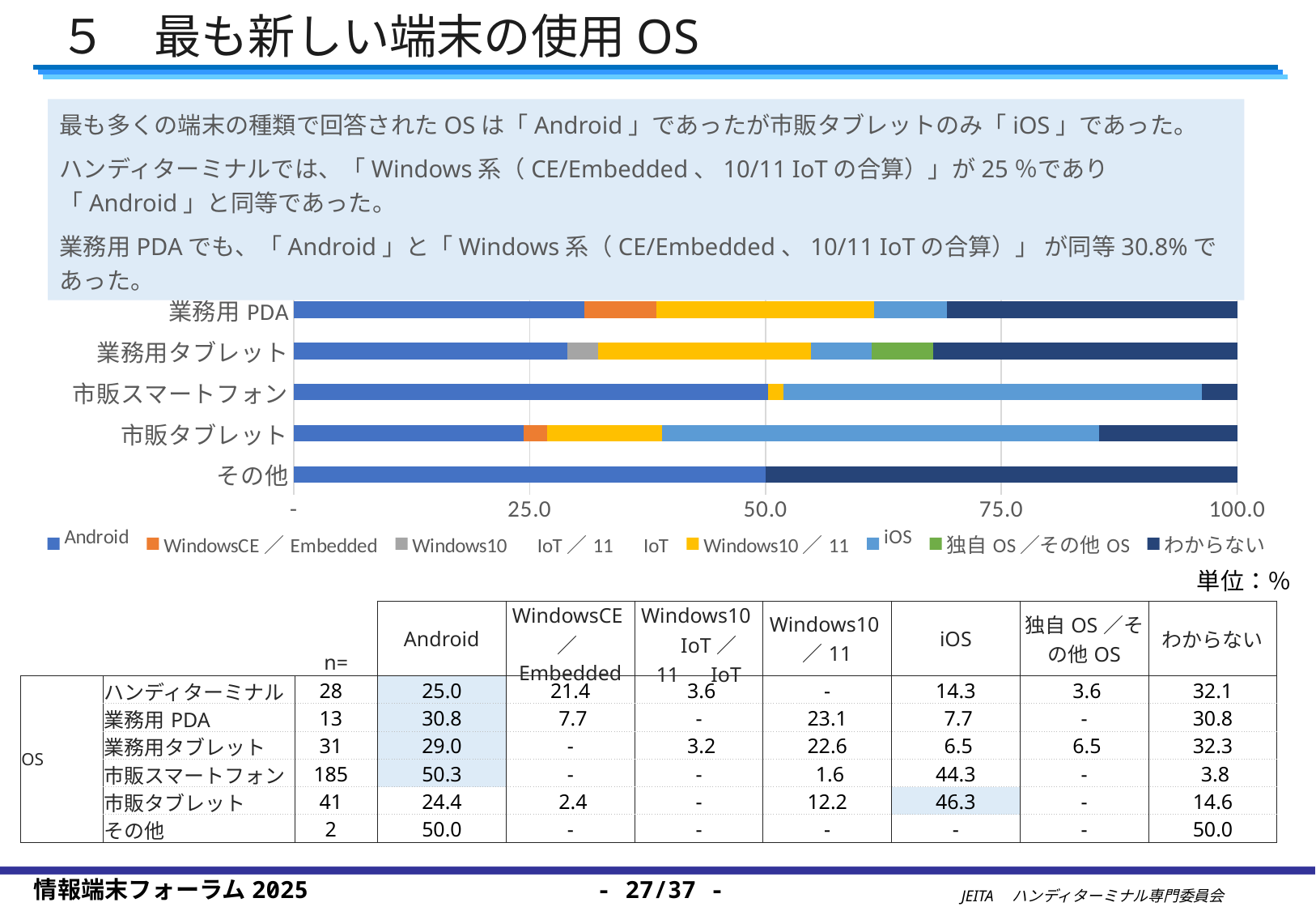
Which device category has the smallest わからない share? 市販スマートフォン What colour represents iOS in the chart legend? light blue What kind of chart is shown on the slide? stacked bar chart What is the difference between the iOS share for 市販タブレット and the iOS share for 市販スマートフォン? 2.0 What is the iOS share for 市販タブレット? 46.3 How many device categories are visible on the chart's vertical axis? 5 What is the Android share for 市販スマートフォン? 50.3 Which is larger for 業務用PDA: the Android share or the Windows10／11 share? Android How many series does the chart legend list? 7 Which device category has the largest Android share? 市販スマートフォン What is the わからない share for 業務用タブレット? 32.3 Is the Android share for 市販スマートフォン greater or less than 50.0? greater